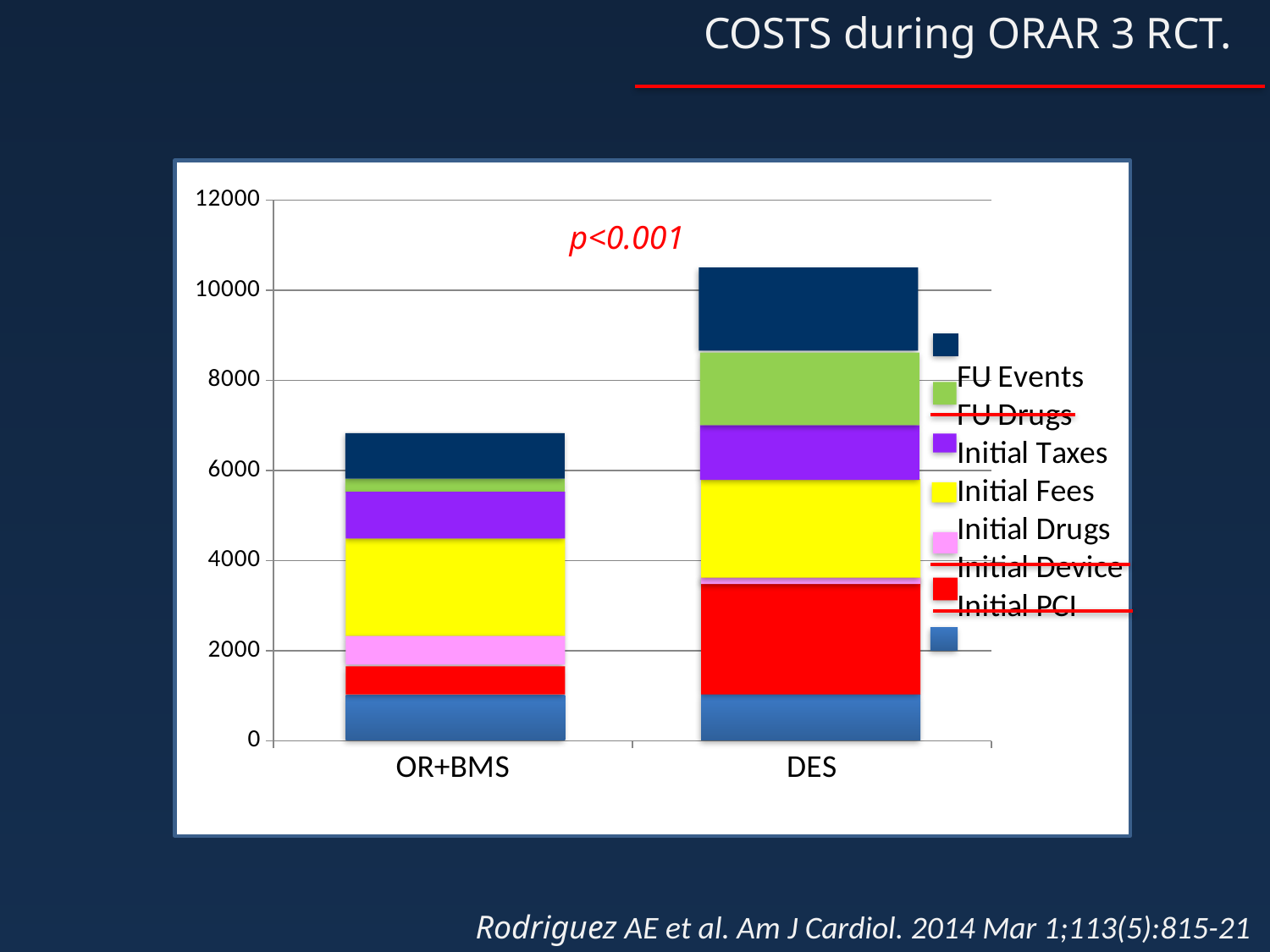
Which category has the lowest total cost? OR+BMS Is the total value of the OR+BMS bar greater or less than 8000? less How many series does the chart's legend list? 7 What kind of chart is shown on the slide? stacked bar chart Which category has the taller stacked bar, OR+BMS or DES? DES How many categories are shown on the x axis of the chart? 2 What p-value is printed on the chart? p<0.001 Is the total value of the DES bar greater or less than 10000? greater Which category has the highest total cost? DES Is the total value of the OR+BMS bar greater or less than 6000? greater What is the maximum value shown on the y axis of the chart? 12000